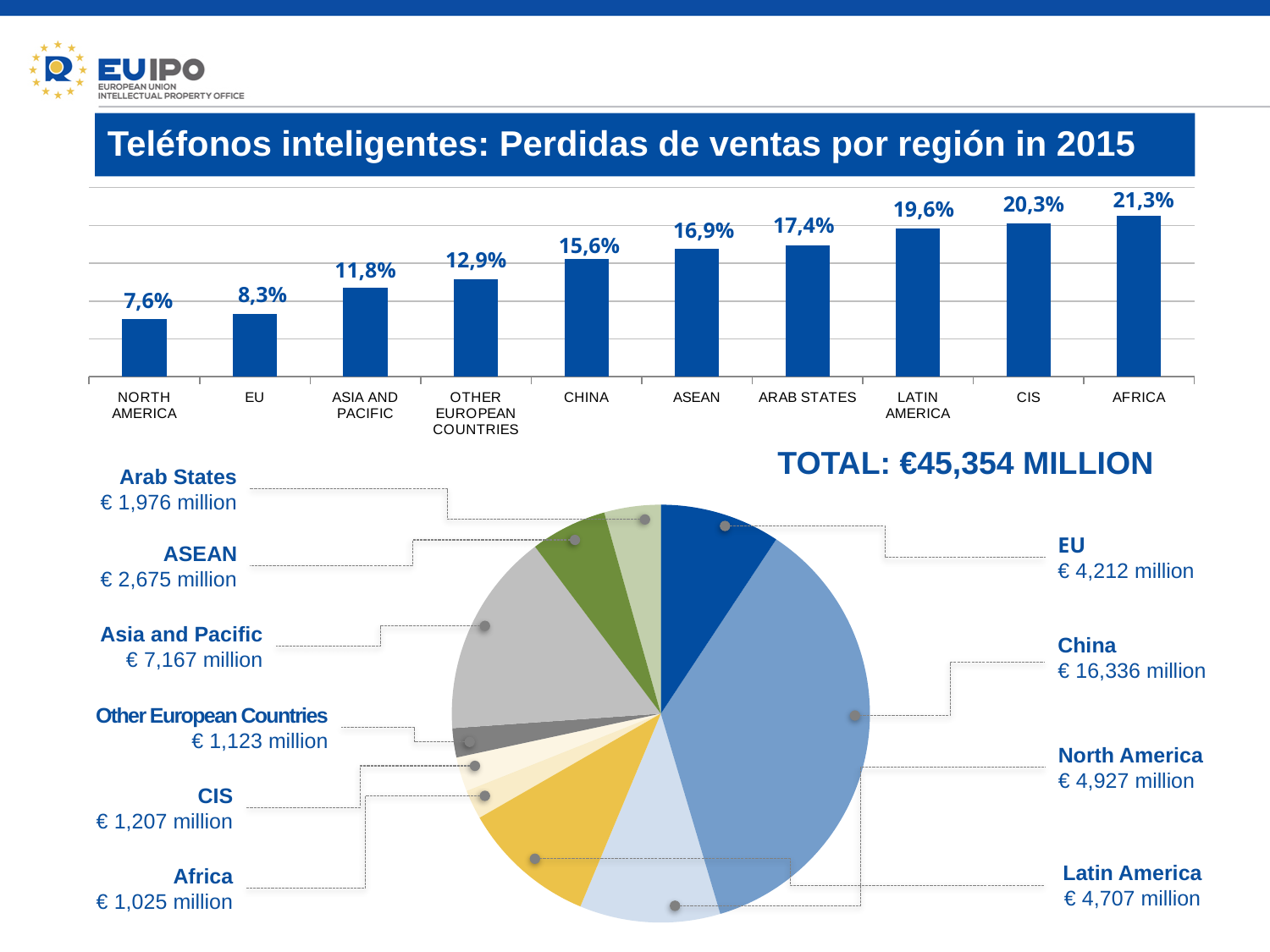
What total is shown next to the pie chart? €45,354 MILLION In the bar chart, what is the difference between the values for Africa and North America? 13,7 percentage points In the pie chart, what is the value for Other European Countries? € 1,123 million In the pie chart, which region has the smallest value? Africa In the pie chart, what is the value for China? € 16,336 million In the bar chart, which is larger, the value for ASEAN or the value for Arab States? Arab States In the bar chart, what is the value for China? 15,6% In the bar chart, which region has the highest value? Africa In the bar chart, what is the value for Africa? 21,3% In the bar chart, do the values rise or fall from left to right along the x axis? rise How many regions are shown in the bar chart? 10 In the bar chart, which region has the lowest value? North America